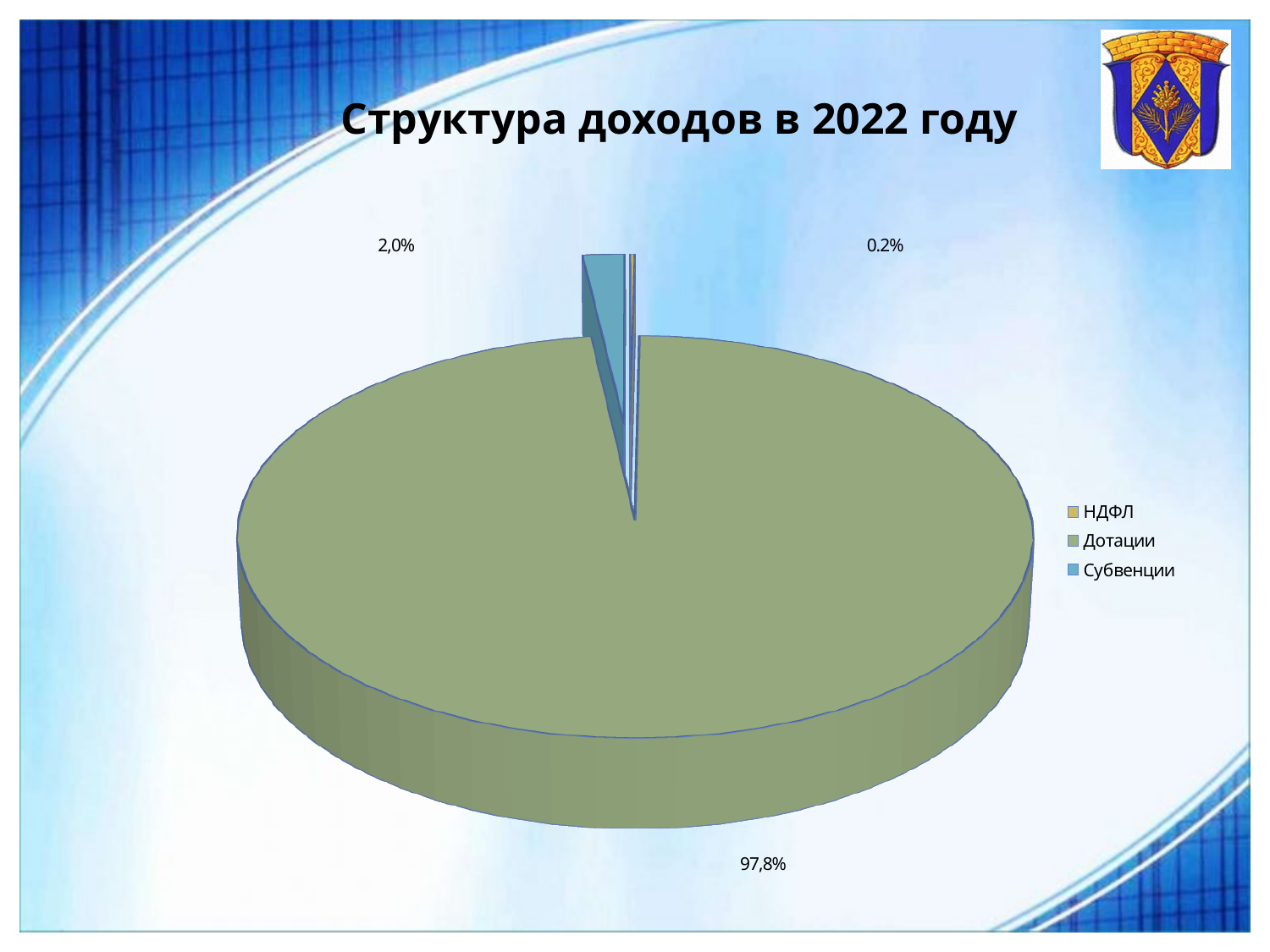
What share of the pie does Субвенции have? 2,0% Which category has the largest share of the pie? Дотации What share of the pie does Дотации have? 97,8% What is the difference between the shares of Субвенции and НДФЛ? 1,8% What is the title of the chart? Структура доходов в 2022 году Which category has the smallest share of the pie? НДФЛ How many categories does the legend list? 3 What share of the pie does НДФЛ have? 0.2% Which is larger, the share for Субвенции or the share for НДФЛ? Субвенции What kind of chart is shown on the slide? pie chart Which legend entry is shown in green? Дотации